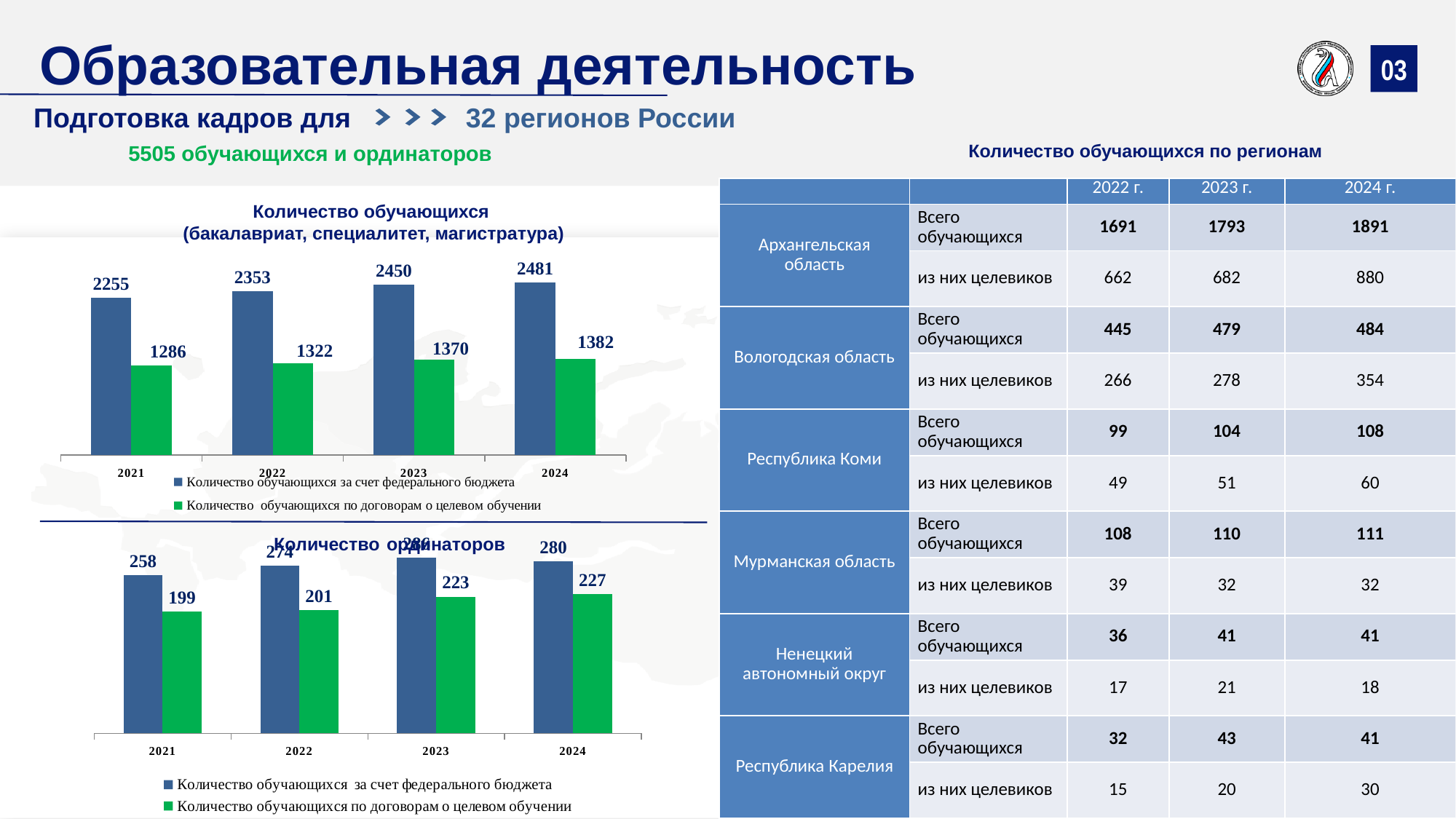
In the chart 'Количество обучающихся (бакалавриат, специалитет, магистратура)', what is the difference between the federal budget value in 2024 and in 2021? 226 In the chart 'Количество ординаторов', what is the value for 'Количество обучающихся за счет федерального бюджета' in 2021? 258 In the chart 'Количество обучающихся (бакалавриат, специалитет, магистратура)', what is the value for 'Количество обучающихся за счет федерального бюджета' in 2024? 2481 In the chart 'Количество обучающихся (бакалавриат, специалитет, магистратура)', which year has the highest value for 'Количество обучающихся за счет федерального бюджета'? 2024 In the chart 'Количество обучающихся (бакалавриат, специалитет, магистратура)', does the value for 'Количество обучающихся за счет федерального бюджета' rise or fall from 2021 to 2024? rise How many series does the legend of the chart 'Количество обучающихся (бакалавриат, специалитет, магистратура)' list? 2 In the chart 'Количество ординаторов', what is the value for 'Количество обучающихся по договорам о целевом обучении' in 2024? 227 What kind of chart is 'Количество ординаторов'? bar chart In the chart 'Количество ординаторов', how many years are shown on the x axis? 4 In the chart 'Количество обучающихся (бакалавриат, специалитет, магистратура)', which year has the lowest value for 'Количество обучающихся по договорам о целевом обучении'? 2021 In the chart 'Количество ординаторов', which is larger in 2022: the federal budget value or the targeted training contracts value? federal budget (274) In the chart 'Количество обучающихся (бакалавриат, специалитет, магистратура)', what is the value for 'Количество обучающихся по договорам о целевом обучении' in 2021? 1286